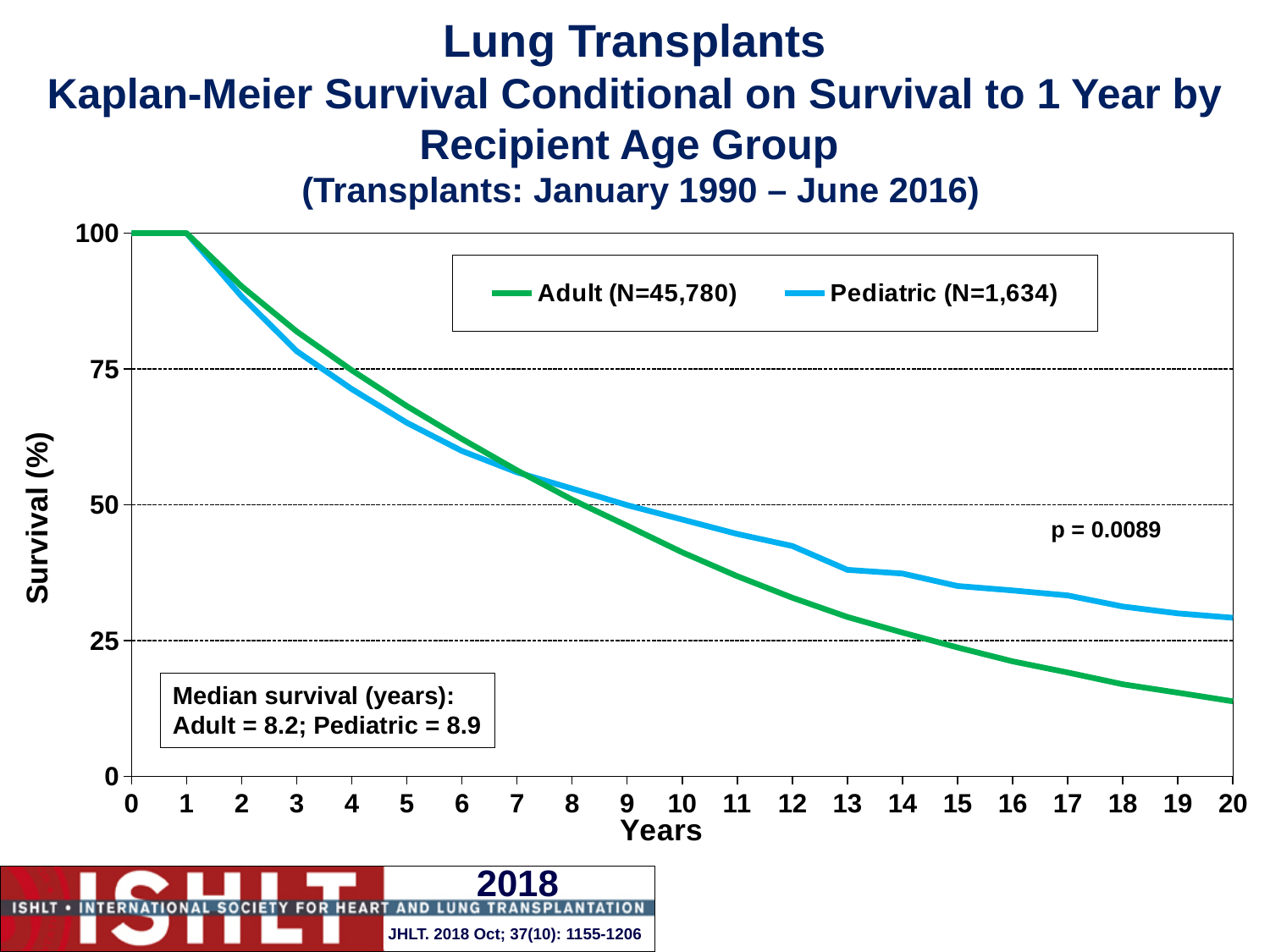
What are the two series named in the legend? Adult (N=45,780) and Pediatric (N=1,634) Which group has the higher survival at 20 years, Adult or Pediatric? Pediatric How many recipients (N) are in the Pediatric group? 1,634 Is the Adult survival at 10 years greater or less than 50? less How many series does the legend list? 2 What is the label of the y axis? Survival (%) Is the Adult survival at 20 years greater or less than 25? less What kind of chart is shown on the slide? Line chart What is the median survival in years for the Adult group? 8.2 What is the median survival in years for the Pediatric group? 8.9 What p-value is shown on the chart? p = 0.0089 Do the survival curves rise or fall as years increase? Fall